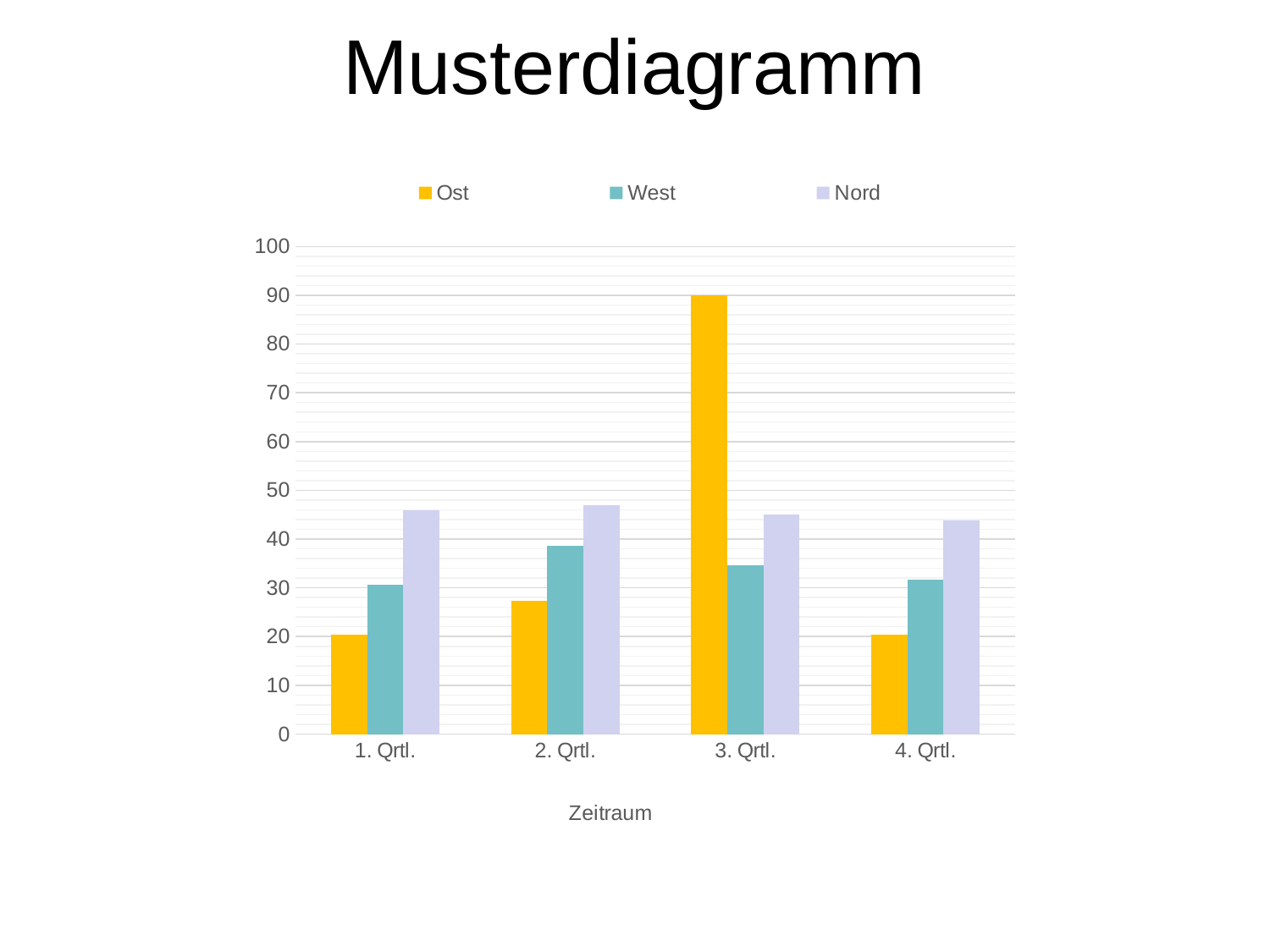
What is the label of the x axis? Zeitraum In which quarter is the value for Ost highest? 3. Qrtl. In which quarter is the value for West highest? 2. Qrtl. What kind of chart is shown on the slide? bar chart In 1. Qrtl., which is larger, Ost or West? West What is the title of the slide? Musterdiagramm What is the value for Ost in 3. Qrtl.? 90 Is the value for Ost in 2. Qrtl. greater or less than 30? less How many categories are shown on the x axis? 4 Is the value for Nord in 1. Qrtl. greater or less than 40? greater In 3. Qrtl., which is larger, Ost or Nord? Ost How many series does the legend list? 3